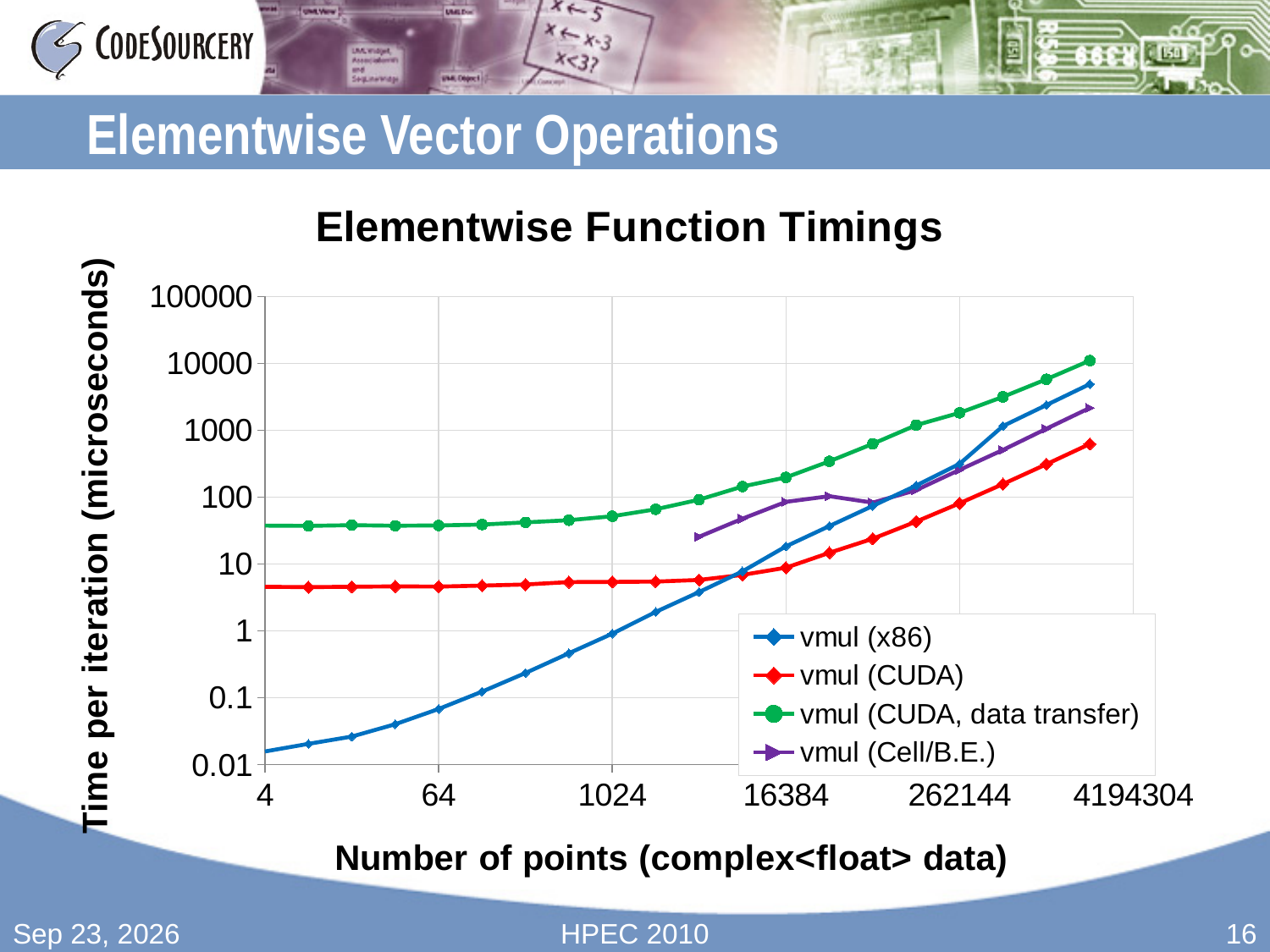
What is the title of the chart? Elementwise Function Timings Does the vmul (x86) series rise or fall as the number of points increases? rise What kind of chart is shown on the slide? line chart Which series has the lowest value at 4 points? vmul (x86) Is the value for vmul (x86) at 4194304 points greater or less than 1000? greater At 4194304 points, which is larger: vmul (x86) or vmul (CUDA)? vmul (x86) Is the value for vmul (CUDA) at 4194304 points greater or less than 1000? less Is the value for vmul (CUDA, data transfer) at 4 points greater or less than 10? greater Which series has the highest value at 4194304 points? vmul (CUDA, data transfer) How many series does the legend list? 4 What is the label of the y axis? Time per iteration (microseconds)